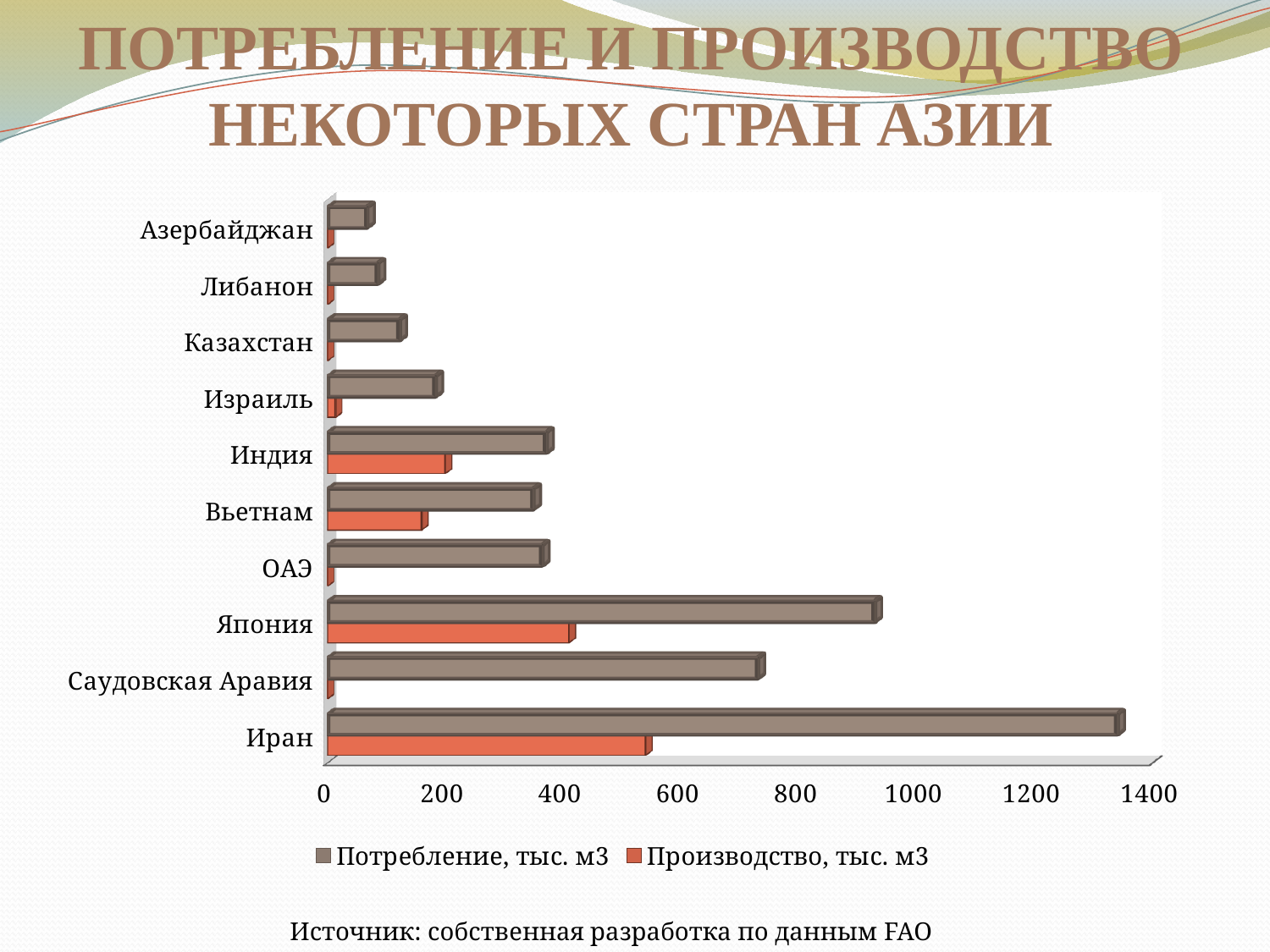
Is the value of Производство, тыс. м3 for Вьетнам greater or less than 200? less Which is larger: Потребление, тыс. м3 for Япония or for Саудовская Аравия? Япония Is the value of Потребление, тыс. м3 for Япония greater or less than 800? greater Which country has the highest value for Потребление, тыс. м3? Иран Is the value of Потребление, тыс. м3 for Иран greater or less than 1200? greater What kind of chart is shown on the slide? bar chart What is the title of the chart on the slide? ПОТРЕБЛЕНИЕ И ПРОИЗВОДСТВО НЕКОТОРЫХ СТРАН АЗИИ Which country has the lowest value for Потребление, тыс. м3? Азербайджан How many series does the legend list? 2 Which country has the highest value for Производство, тыс. м3? Иран How many countries are shown on the chart? 10